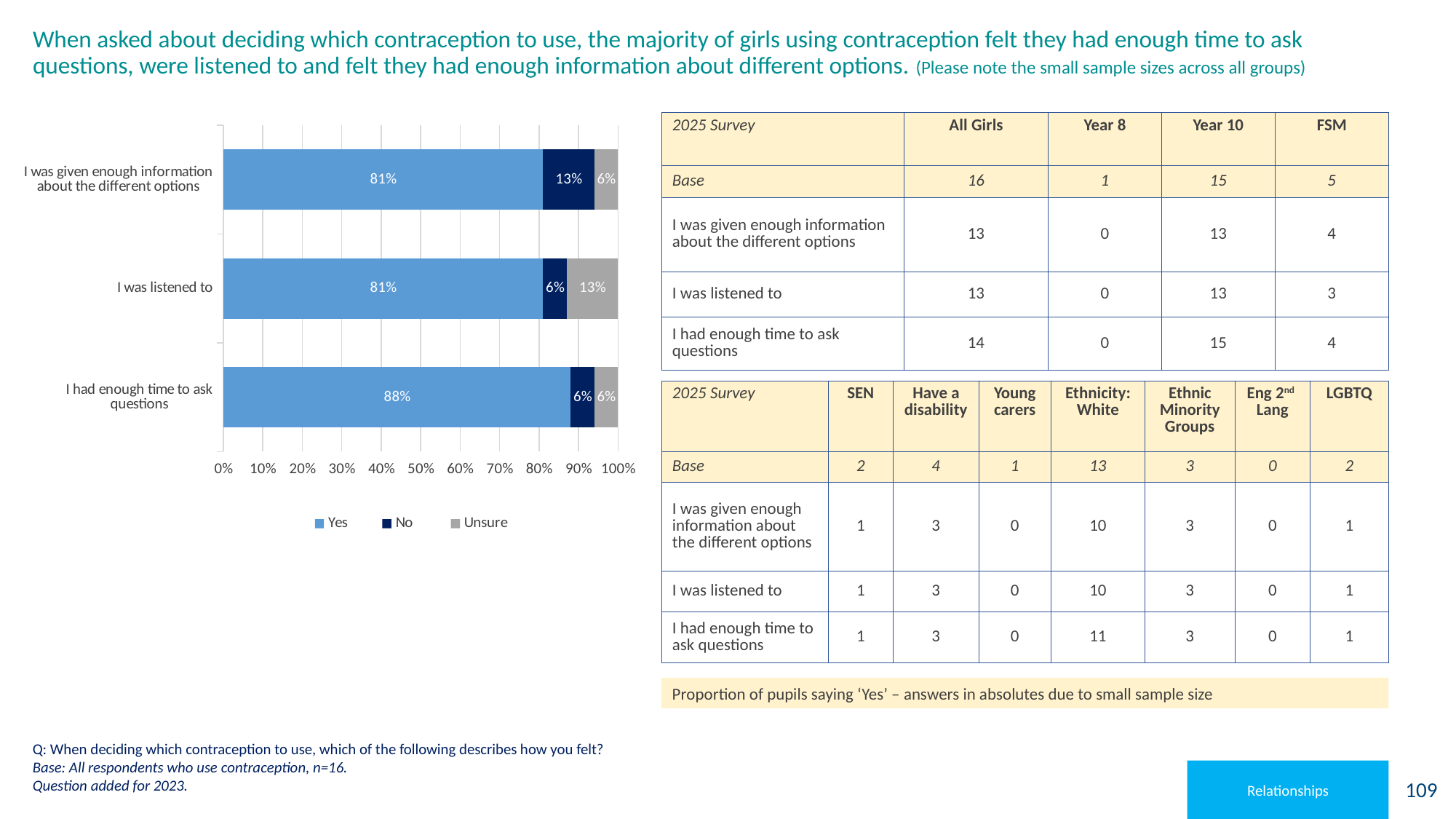
What percentage of girls answered 'Yes' to 'I had enough time to ask questions'? 88% What is the difference between the 'Yes' percentage for 'I had enough time to ask questions' and the 'Yes' percentage for 'I was listened to'? 7% How many series does the chart legend list? 3 Which colour represents the 'Unsure' series in the chart? Grey What type of chart is shown on the slide? Stacked bar chart What percentage of girls answered 'Unsure' to 'I was listened to'? 13% Which statement has the highest 'No' percentage? I was given enough information about the different options Is the 'No' percentage larger for 'I was given enough information about the different options' or for 'I was listened to'? I was given enough information about the different options Which statement has the highest 'Yes' percentage? I had enough time to ask questions What percentage of girls answered 'No' to 'I was given enough information about the different options'? 13% What percentage of girls answered 'Yes' to 'I was listened to'? 81% How many statements (categories) are shown in the chart? 3